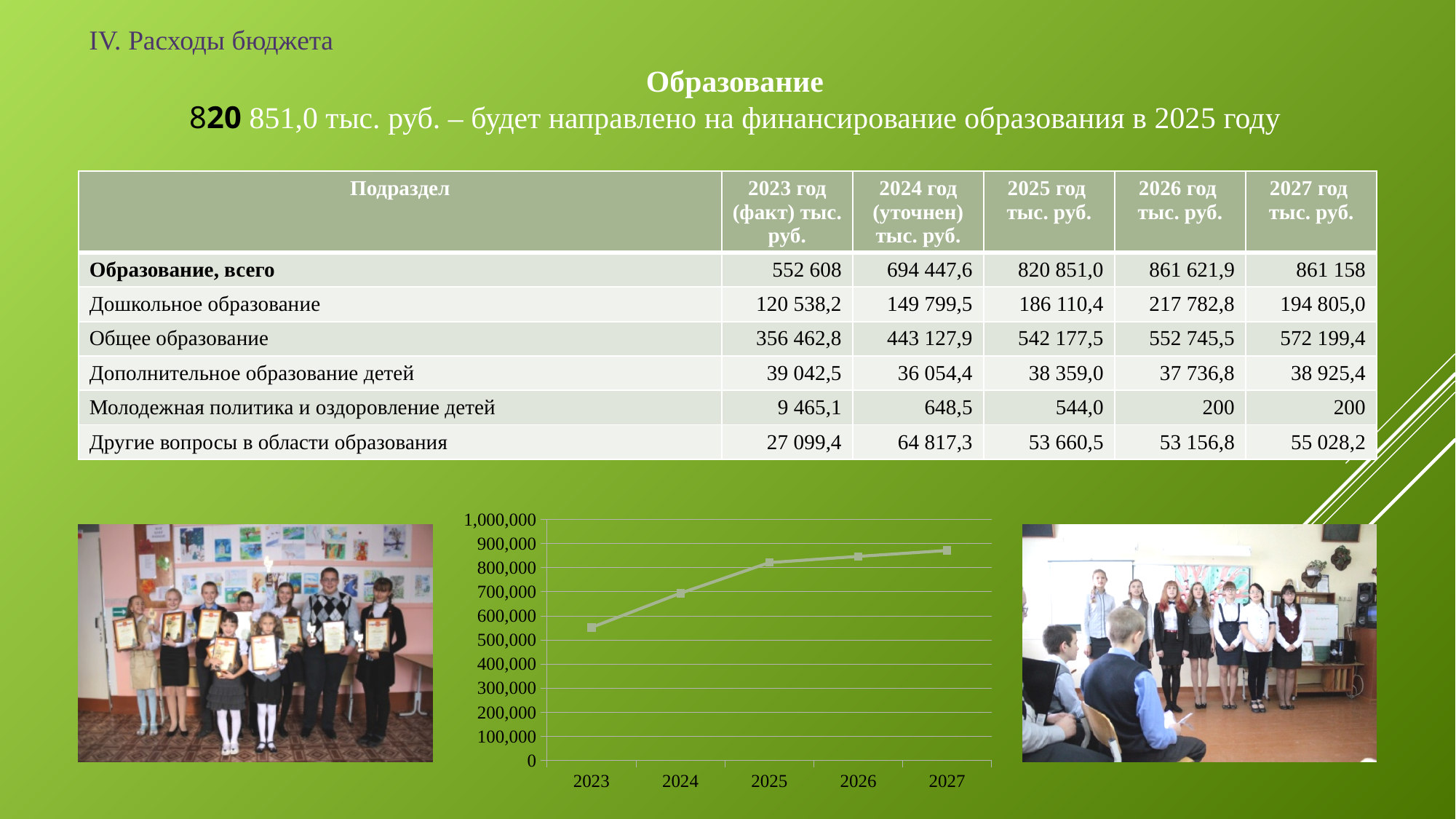
Which year has the lowest value on the line chart? 2023 Is the value for 2023 on the line chart greater or less than 500,000? greater Is the value for 2025 on the line chart greater or less than 800,000? greater What kind of chart is shown on the slide? line chart Is the value for 2027 on the line chart greater or less than 900,000? less Do the values on the line chart rise or fall from 2023 to 2027? rise How many data points are plotted on the line chart? 5 What is the highest tick value shown on the y axis of the line chart? 1,000,000 On the line chart, which is larger: the value for 2024 or the value for 2026? 2026 On the line chart, which is larger: the value for 2023 or the value for 2025? 2025